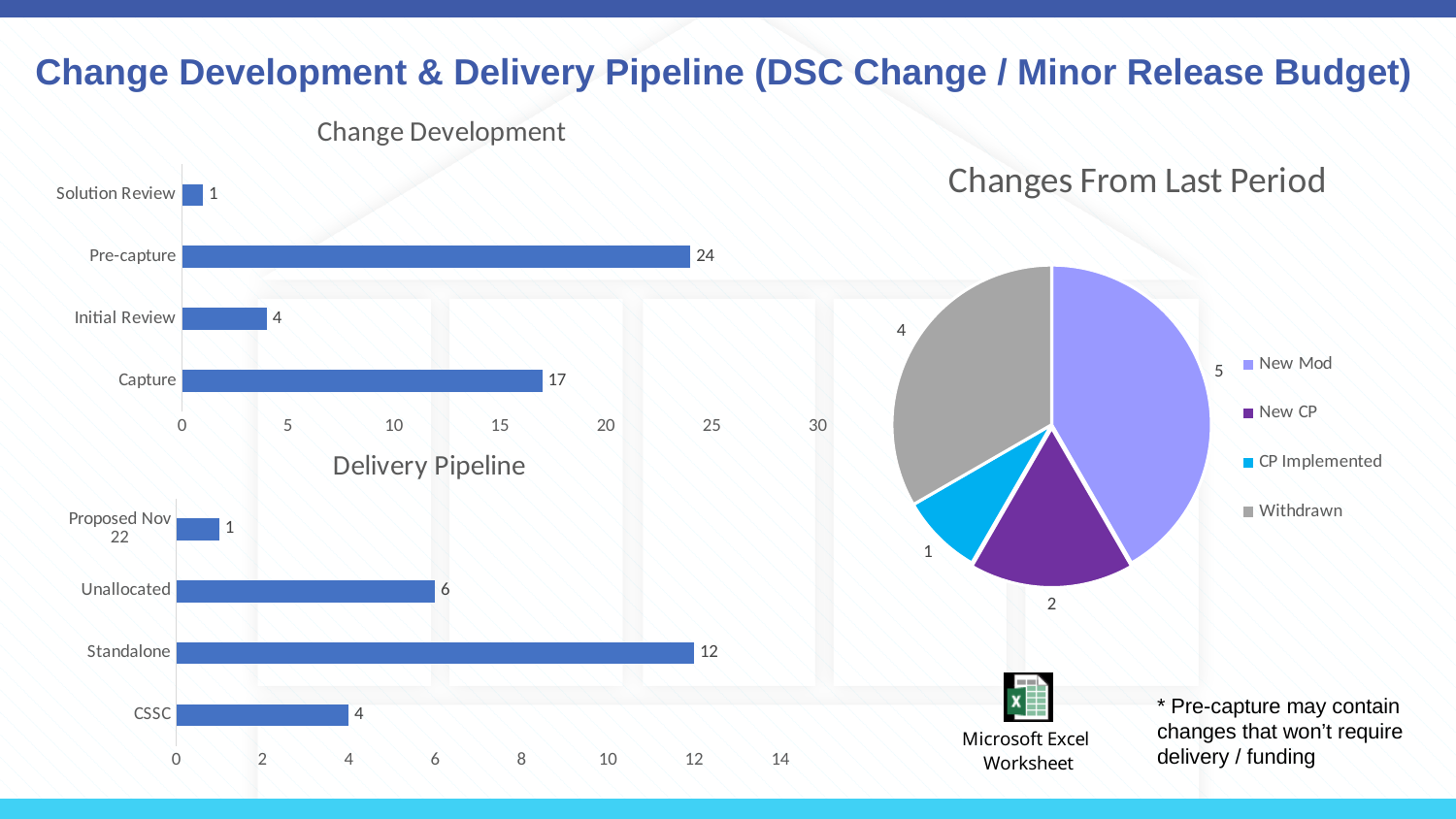
In the Change Development chart, how many categories are shown? 4 In the Delivery Pipeline chart, which is larger, Unallocated or CSSC? Unallocated How many entries does the legend of the Changes From Last Period pie chart list? 4 In the Change Development chart, which category has the lowest value? Solution Review In the Delivery Pipeline chart, what is the value for Proposed Nov 22? 1 What kind of chart is the Delivery Pipeline chart? Bar chart In the Change Development chart, what is the value for Pre-capture? 24 In the Delivery Pipeline chart, what is the value for Standalone? 12 In the Changes From Last Period pie chart, which category has the largest slice? New Mod In the Changes From Last Period pie chart, what is the value for Withdrawn? 4 In the Change Development chart, what is the difference between Pre-capture and Capture? 7 In the Delivery Pipeline chart, which category has the highest value? Standalone